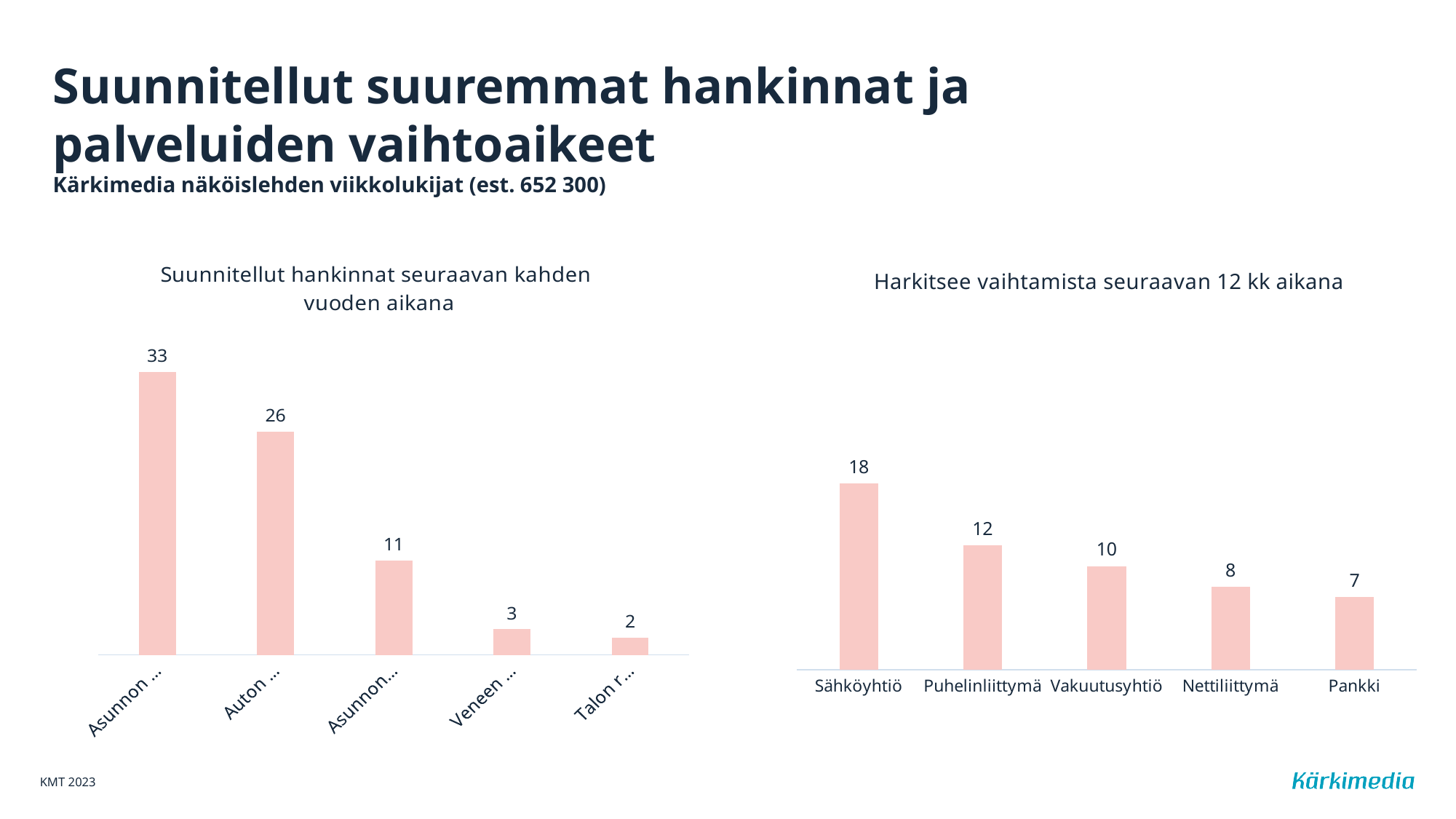
In the chart titled "Harkitsee vaihtamista seuraavan 12 kk aikana", what is the difference between the values for Sähköyhtiö and Puhelinliittymä? 6 In the chart titled "Harkitsee vaihtamista seuraavan 12 kk aikana", which is larger, the value for Nettiliittymä or the value for Puhelinliittymä? Puhelinliittymä In the chart titled "Harkitsee vaihtamista seuraavan 12 kk aikana", what is the value for Pankki? 7 What kind of chart is the chart on the left of the slide? bar chart In the chart titled "Harkitsee vaihtamista seuraavan 12 kk aikana", what is the value for Sähköyhtiö? 18 In the chart titled "Harkitsee vaihtamista seuraavan 12 kk aikana", do the values rise or fall from left to right? fall In the chart on the left titled "Suunnitellut hankinnat seuraavan kahden vuoden aikana", how many bars are shown? 5 In the chart titled "Harkitsee vaihtamista seuraavan 12 kk aikana", which category has the highest value? Sähköyhtiö In the chart titled "Harkitsee vaihtamista seuraavan 12 kk aikana", what is the value for Vakuutusyhtiö? 10 In the chart titled "Harkitsee vaihtamista seuraavan 12 kk aikana", which category has the lowest value? Pankki In the chart titled "Harkitsee vaihtamista seuraavan 12 kk aikana", how many categories are shown? 5 In the chart on the left titled "Suunnitellut hankinnat seuraavan kahden vuoden aikana", what is the highest value shown? 33